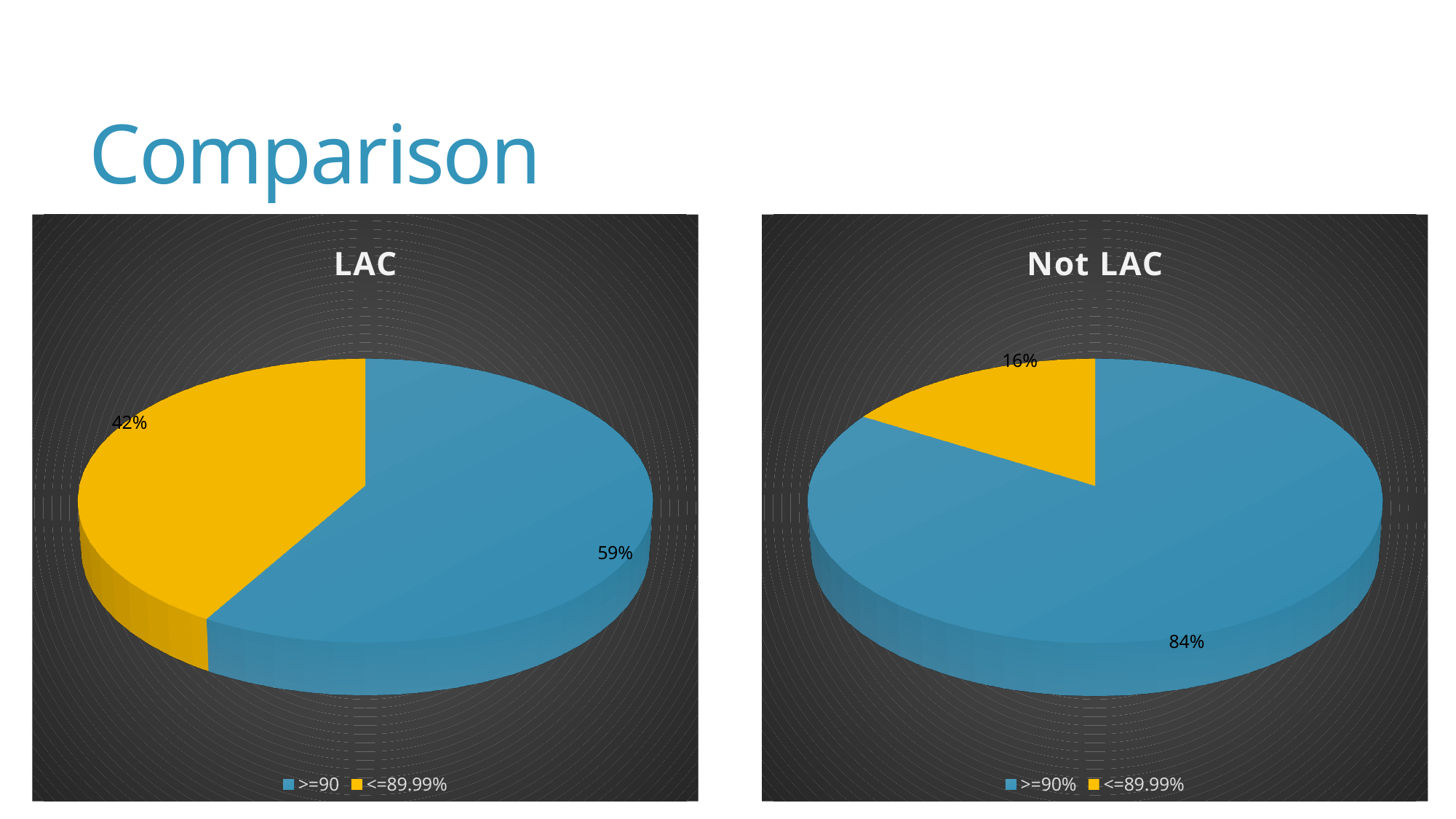
In the Not LAC chart, what share is labelled for the <=89.99% slice? 16% In the LAC chart, what share is labelled for the >=90 slice? 59% In the LAC chart, which slice is the smallest? <=89.99% In the Not LAC chart, which slice is the largest? >=90% How many slices does the Not LAC pie chart have? 2 In the Not LAC chart, what is the difference in percentage points between the >=90% slice and the <=89.99% slice? 68 What kind of chart is the LAC chart? Pie chart Which is larger: the >=90 share in the LAC chart or the >=90% share in the Not LAC chart? Not LAC In the Not LAC chart, what colour is the <=89.99% slice? Yellow In the LAC chart, what share is labelled for the <=89.99% slice? 42% How many entries does the legend of the LAC chart list? 2 In the Not LAC chart, what share is labelled for the >=90% slice? 84%